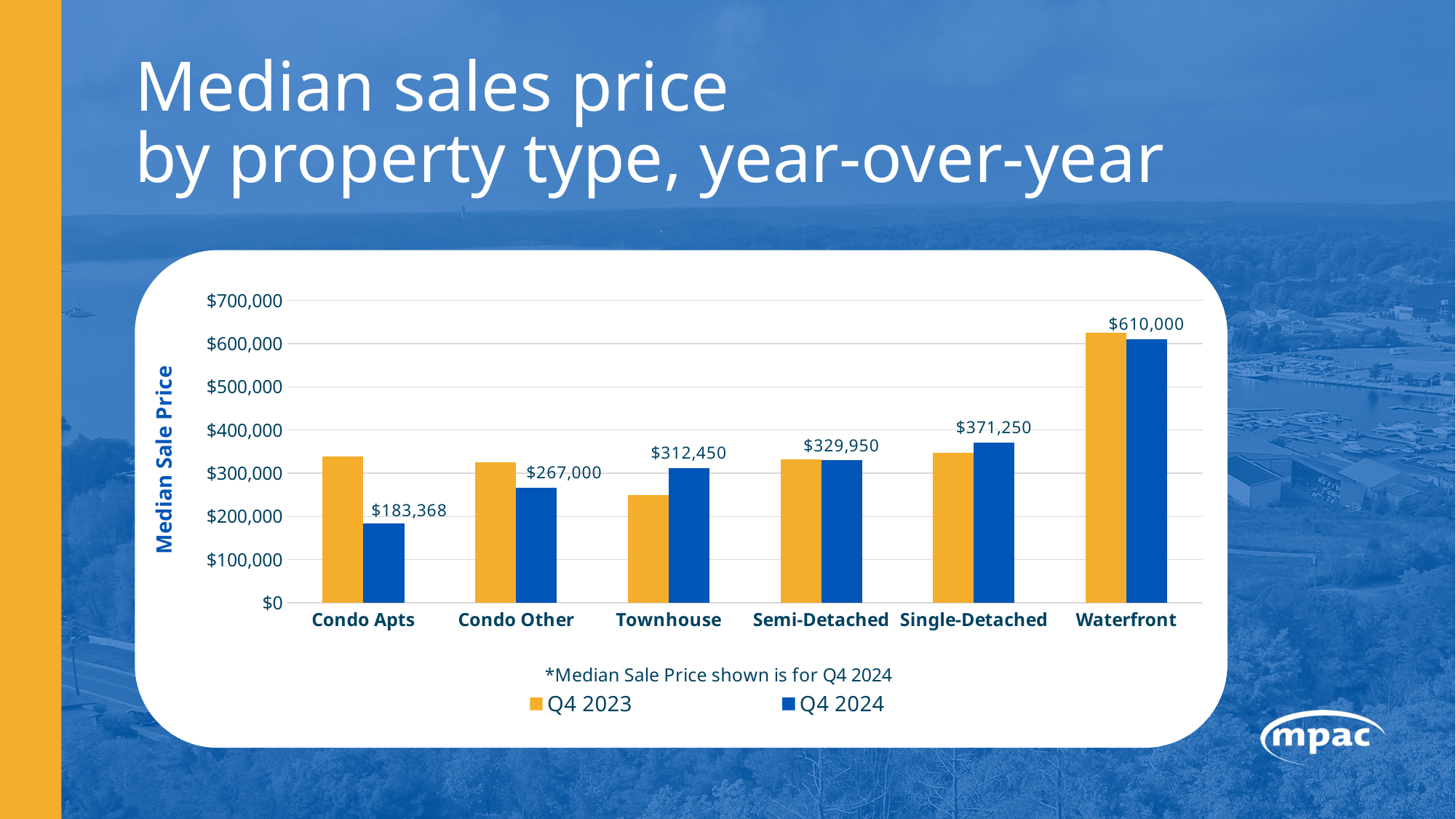
Is the Q4 2023 median sale price for Townhouse greater or less than $300,000? less Which property type has the highest Q4 2024 median sale price? Waterfront What is the Q4 2024 median sale price for Townhouse? $312,450 How many series does the legend list? 2 What kind of chart is shown on the slide? bar chart What is the Q4 2024 median sale price for Condo Apts? $183,368 What is the difference between the Q4 2024 median sale prices for Waterfront and Condo Other? $343,000 What is the Q4 2024 median sale price for Waterfront properties? $610,000 Which property type has the lowest Q4 2024 median sale price? Condo Apts What is the difference between the Q4 2024 median sale prices for Single-Detached and Semi-Detached? $41,300 How many property types are shown on the x axis? 6 For Condo Apts, which is larger: the Q4 2023 or the Q4 2024 median sale price? Q4 2023